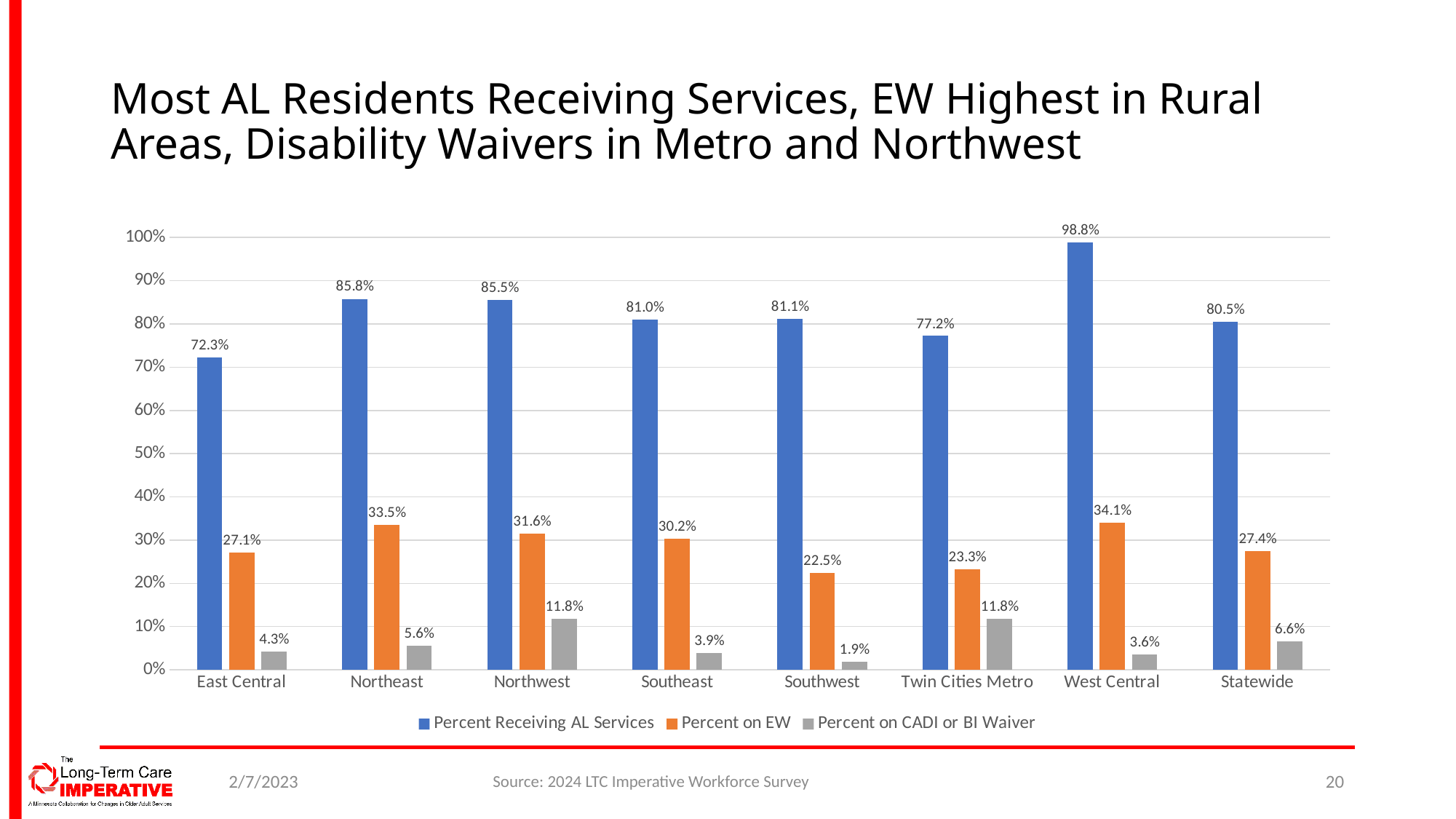
How many series does the legend list? 3 Which region has the lowest Percent on EW? Southwest What is the Percent on CADI or BI Waiver for Southwest? 1.9% What is the Percent Receiving AL Services for West Central? 98.8% Is the Percent Receiving AL Services for East Central greater or less than 80%? less What kind of chart is shown on the slide? Bar chart How many categories are shown on the x axis? 8 Which colour represents Percent on EW in the chart? Orange What is the difference between the Percent on EW for West Central and for Twin Cities Metro? 10.8% Which region has the highest Percent Receiving AL Services? West Central What is the Percent on EW for Northeast? 33.5% Which is larger: the Percent on CADI or BI Waiver for Northwest or for Statewide? Northwest